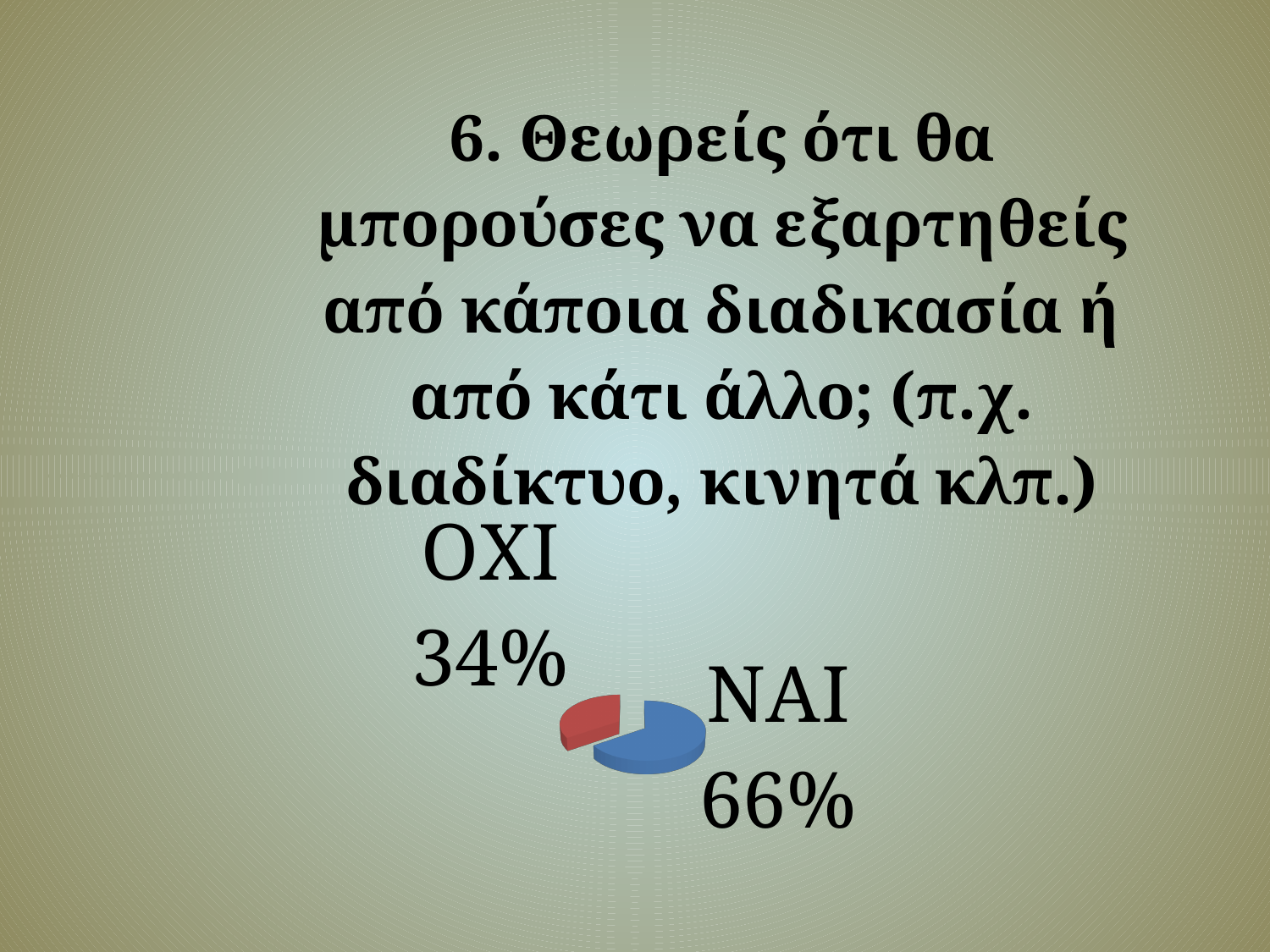
What kind of chart is shown on the slide? pie chart Which is larger, the ΝΑΙ slice or the ΟΧΙ slice? ΝΑΙ What is the difference in percentage points between the ΝΑΙ and ΟΧΙ slices? 32 What percentage of the pie is labelled ΝΑΙ? 66% How many slices does the pie chart have? 2 What share of the pie does the ΟΧΙ slice represent? 34% Which slice of the pie is the largest? ΝΑΙ What colour is the ΟΧΙ slice of the pie? red What percentage of the pie is labelled ΟΧΙ? 34% What colour is the ΝΑΙ slice of the pie? blue Which slice of the pie is the smallest? ΟΧΙ